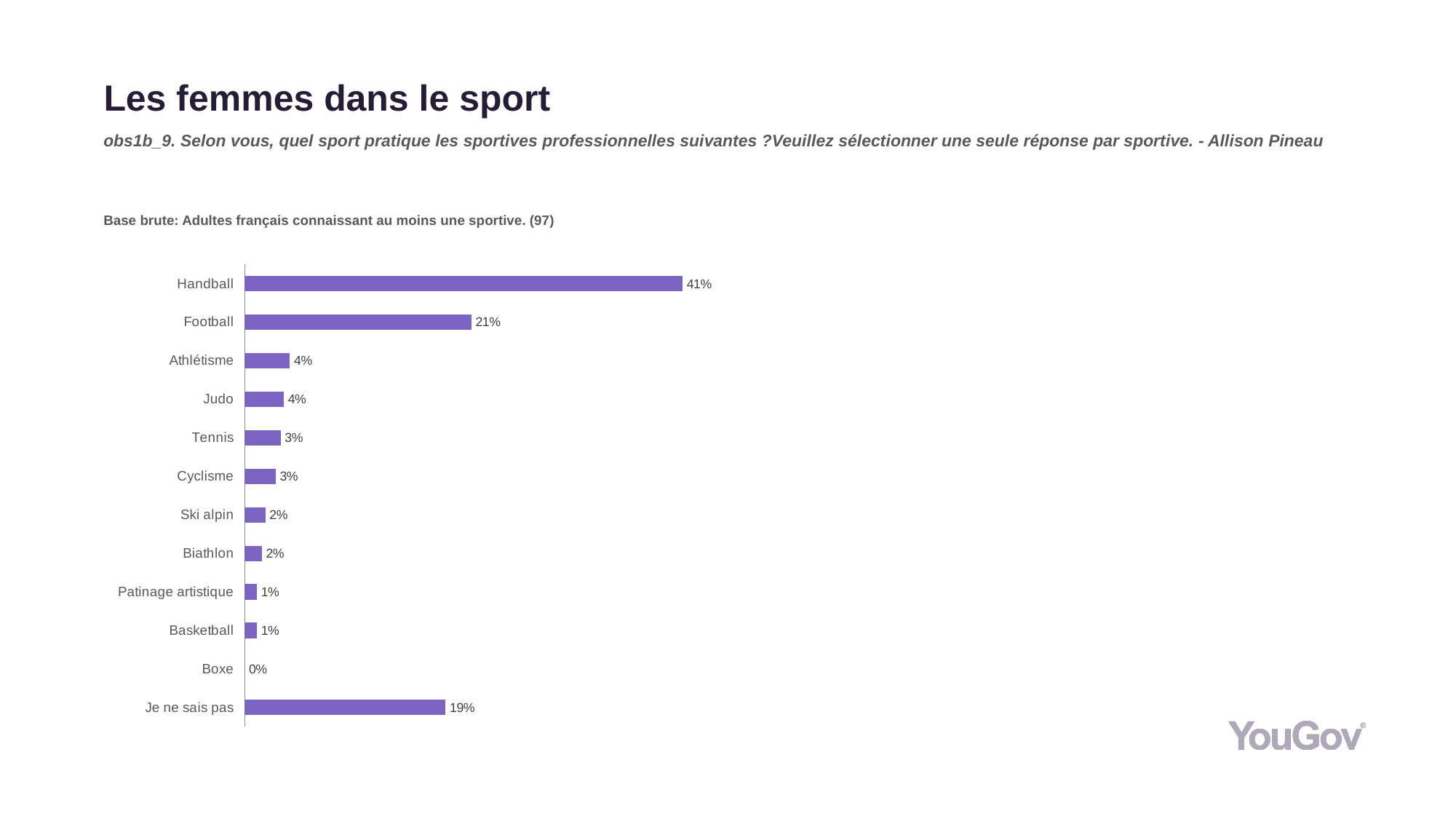
What is the base size stated on the slide? 97 What percentage answered 'Je ne sais pas'? 19% What kind of chart is shown on the slide? Bar chart Which is larger, the value for Football or the value for 'Je ne sais pas'? Football What is the value shown for Boxe? 0% Which category has the lowest value? Boxe What is the difference between the values for Athlétisme and Basketball? 3 percentage points How many categories are shown in the chart? 12 What percentage of respondents said Allison Pineau practises Handball? 41% What is the value shown for Football? 21% What is the difference between the values for Handball and Football? 20 percentage points Which sport has the highest percentage? Handball